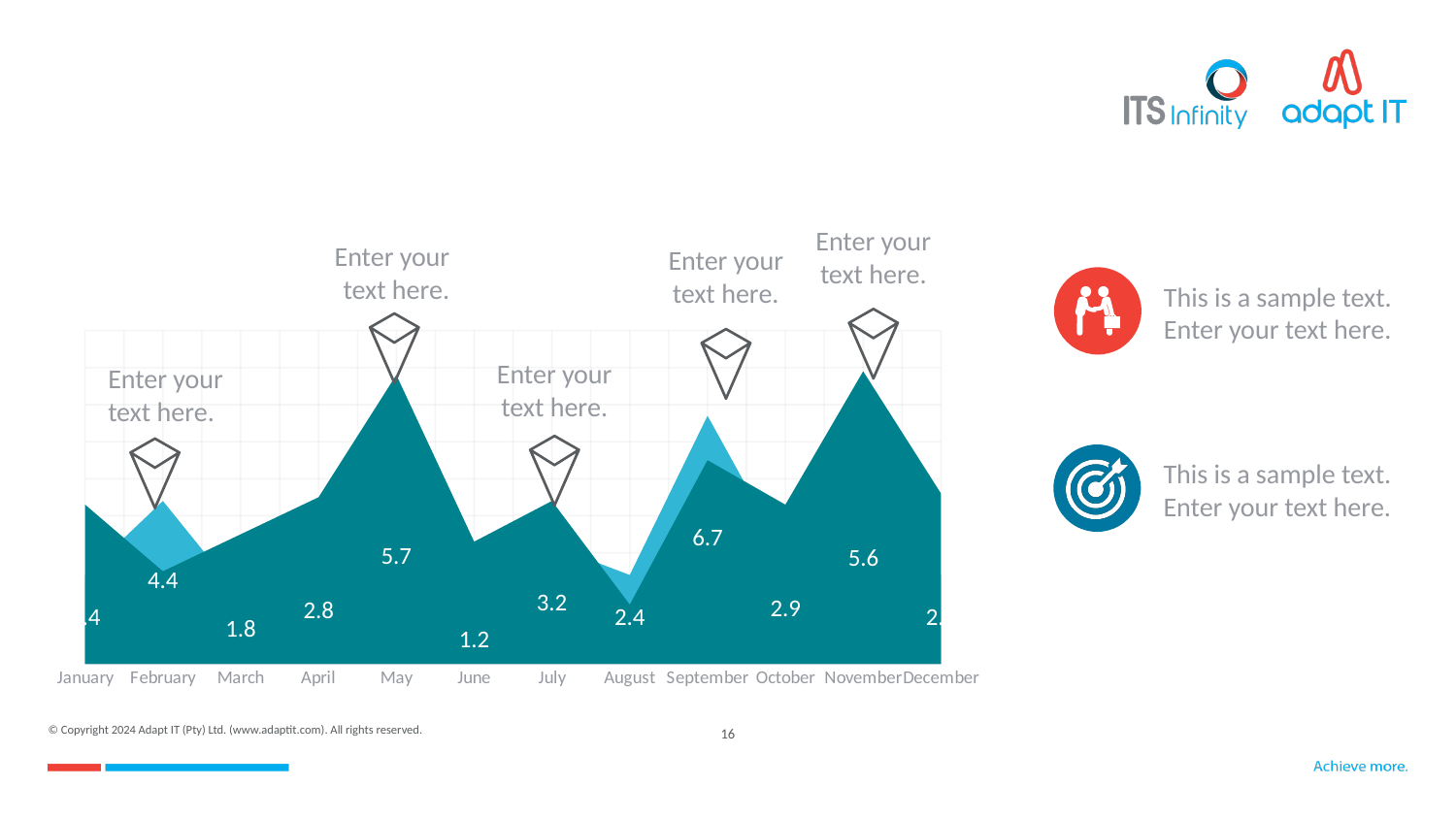
Do the values rise or fall from March to May? rise Which has the larger labelled value, May or June? May What is the value labelled for September? 6.7 What is the value labelled for August? 2.4 What is the value labelled for June? 1.2 How many months are shown along the x axis of the chart? 12 What is the value labelled for May? 5.7 What is the value labelled for February? 4.4 What is the difference between the labelled values for May and March? 3.9 Which month has the lowest labelled value? June What kind of chart is shown on the slide? area chart What is the value labelled for November? 5.6